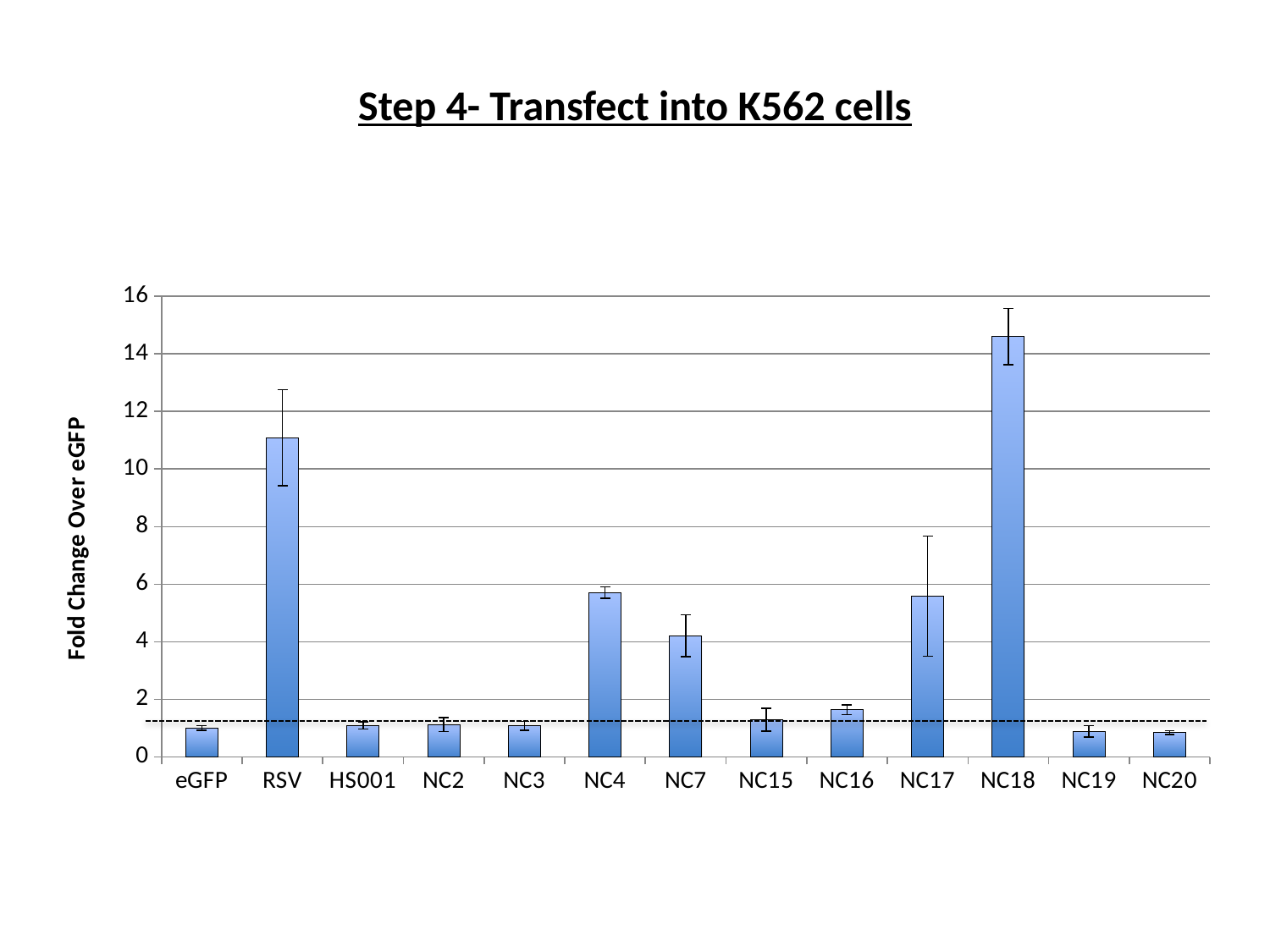
Is the value for NC16 greater or less than 2? less How many categories are plotted along the x axis? 13 Which has a larger value, RSV or NC18? NC18 Which has a larger value, NC17 or NC16? NC17 What kind of chart is shown on the slide? bar chart Is the value for RSV greater or less than 10? greater Is the value for NC18 greater or less than 14? greater Which has a larger value, NC4 or NC7? NC4 What is the label of the y axis? Fold Change Over eGFP Which category has the highest fold change over eGFP? NC18 What is the title shown above the chart on the slide? Step 4- Transfect into K562 cells